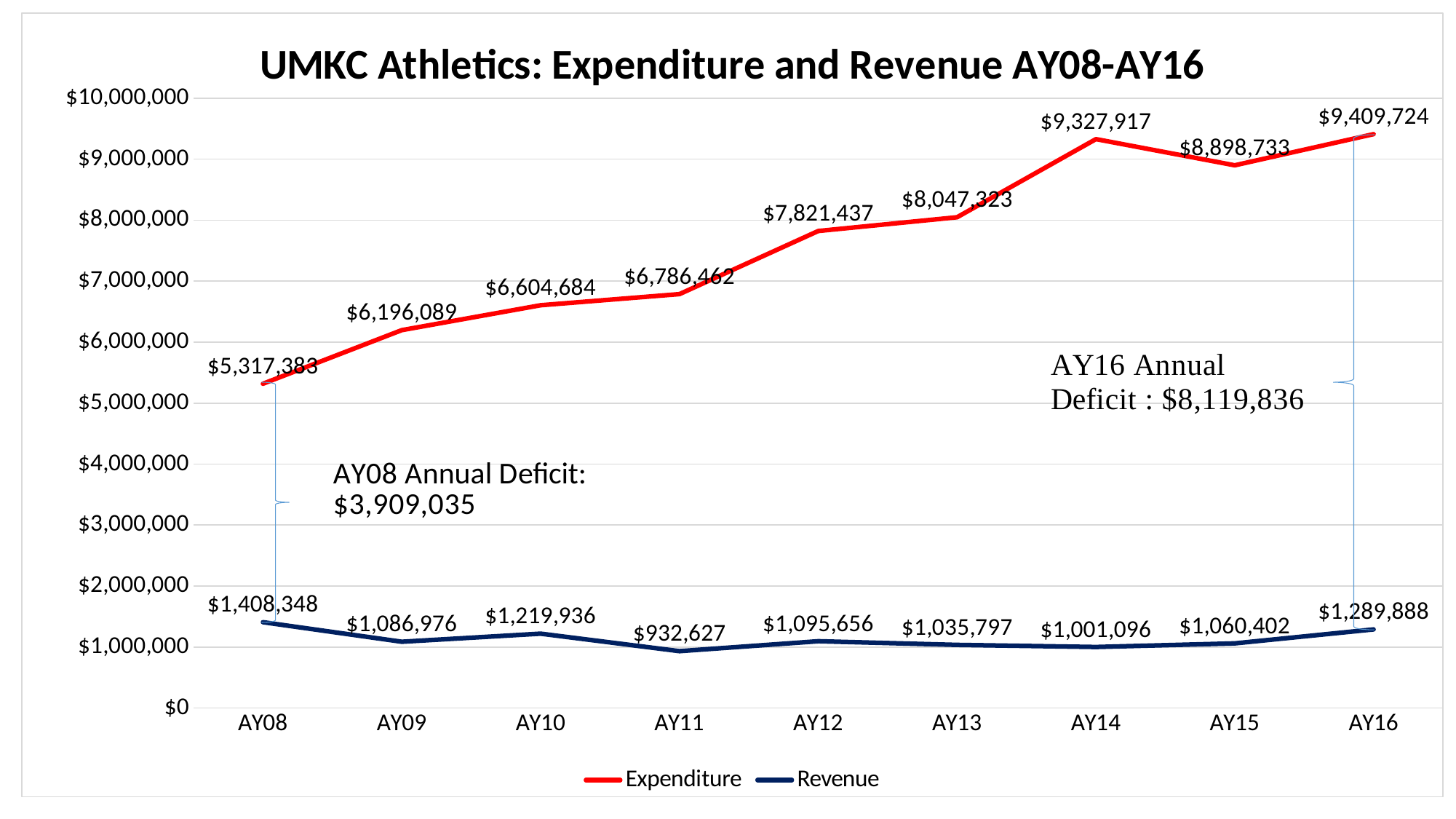
Which year has the lowest Revenue? AY11 What is the AY16 Annual Deficit stated on the slide? $8,119,836 Which is larger, the Expenditure in AY14 or the Expenditure in AY15? AY14 How many years are plotted on the x axis? 9 Is the Expenditure for AY13 greater or less than $8,000,000? greater What is the difference between the Revenue in AY08 and AY11? $475,721 What is the Expenditure value for AY12? $7,821,437 Which year has the highest Expenditure? AY16 What is the difference between the Expenditure in AY16 and AY15? $510,991 What is the Revenue value for AY10? $1,219,936 What kind of chart is shown on the slide? line chart How many series does the legend list? 2